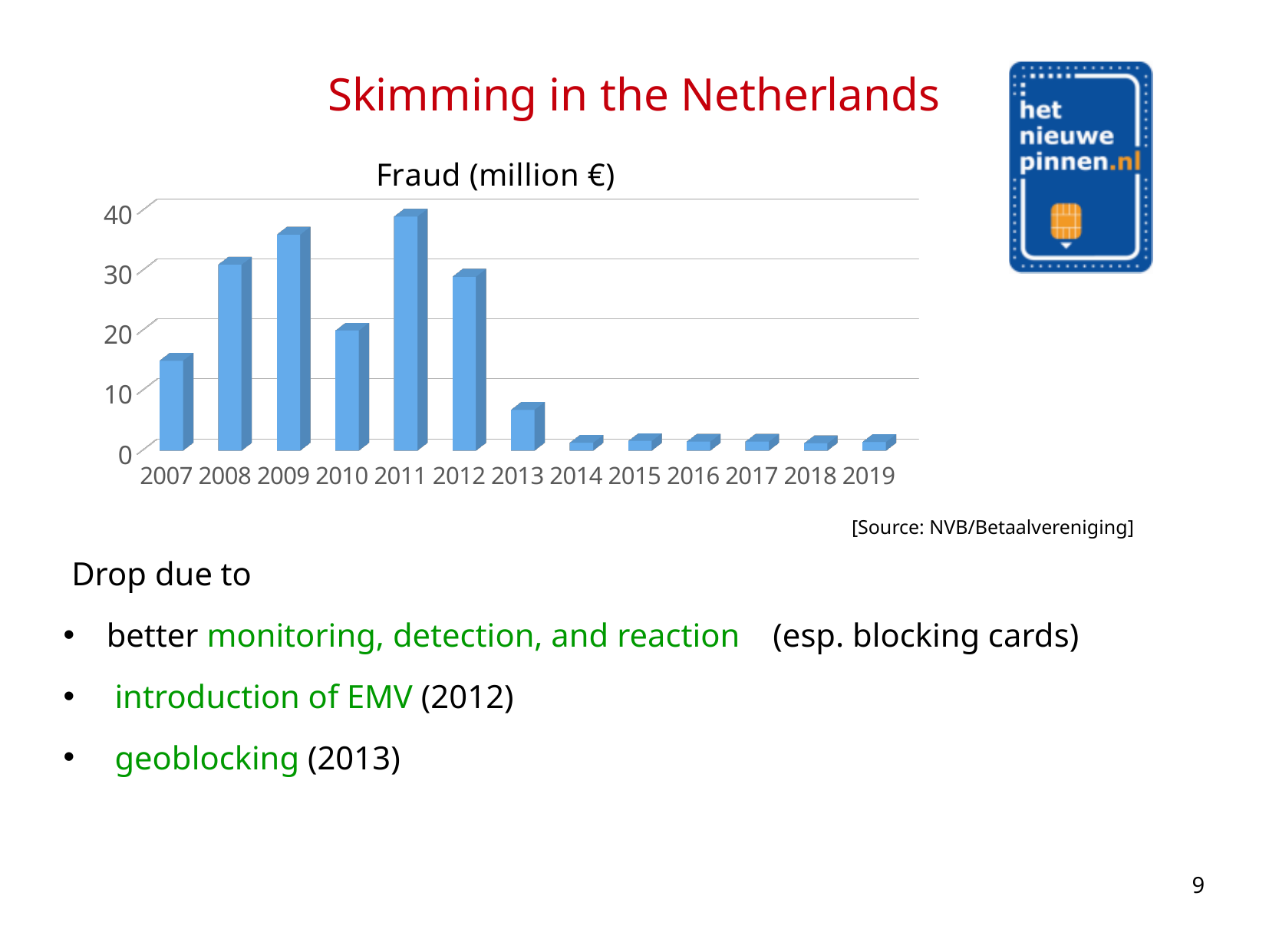
Which year has the highest fraud value in the chart? 2011 Is the fraud value for 2012 greater or less than 20? greater What kind of chart is shown on the slide? bar chart Is the fraud value for 2013 greater or less than 10? less Which year has the larger fraud value, 2007 or 2013? 2007 Which year has the larger fraud value, 2008 or 2009? 2009 Is the fraud value for 2016 greater or less than 10? less How many years are shown on the x axis of the chart? 13 What is the title of the chart? Fraud (million €) Do the fraud values rise or fall from 2011 to 2019? fall